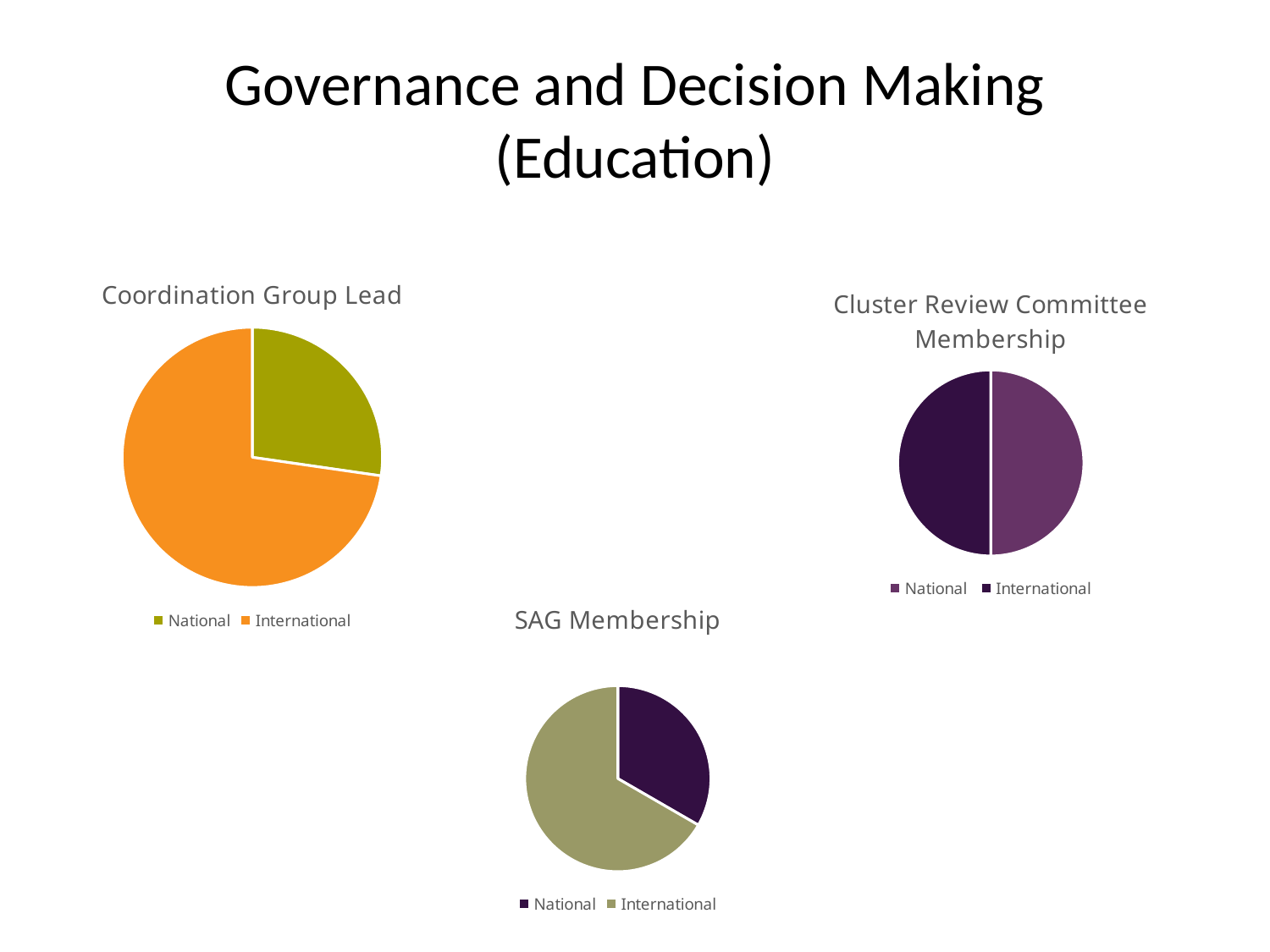
What kind of chart is the "Coordination Group Lead" chart? pie chart In the "Coordination Group Lead" chart, how many slices does the pie have? 2 In the "SAG Membership" chart, which category has the largest slice? International What is the title of the pie chart at the top right of the slide? Cluster Review Committee Membership What are the two legend entries in the "SAG Membership" chart? National and International In the "SAG Membership" chart, which slice is larger, National or International? International In the "Coordination Group Lead" chart, which category has the largest slice? International In the "Coordination Group Lead" chart, which category has the smallest slice? National How many pie charts are shown on the slide? 3 How many entries does the legend of the "Cluster Review Committee Membership" chart list? 2 In the "Coordination Group Lead" chart, which slice is smaller, National or International? National What kind of chart is the "SAG Membership" chart? pie chart